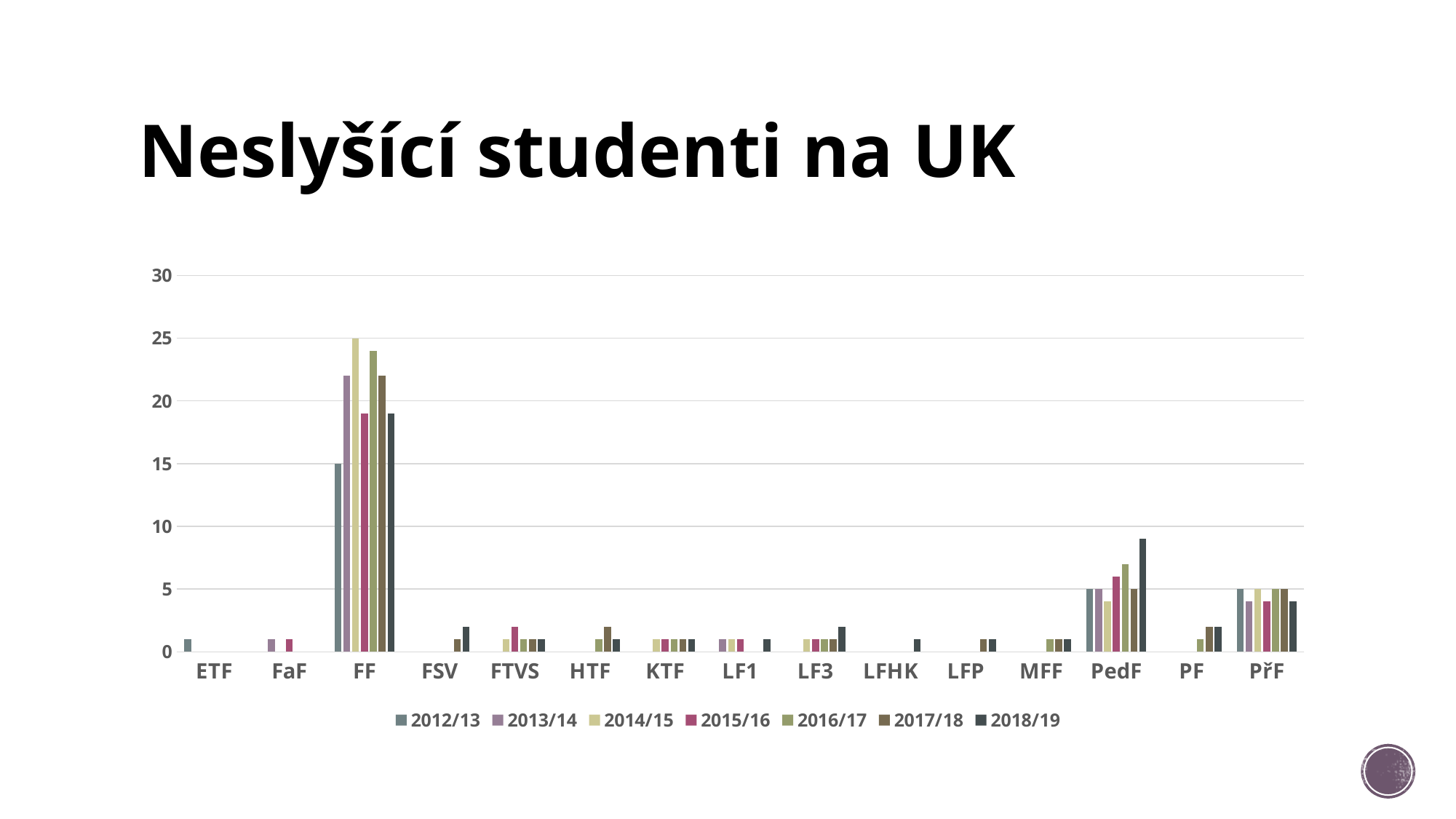
Which is larger: the value for FF in 2014/15 or the value for FF in 2015/16? FF in 2014/15 Which faculty has the highest number of deaf students across the years shown? FF Which is larger: the value for PedF in 2018/19 or the value for PřF in 2018/19? PedF in 2018/19 How many faculty categories are shown on the x axis? 15 What is the title of the chart slide? Neslyšící studenti na UK What kind of chart is shown on the slide? bar chart Is the value for PedF in 2018/19 greater or less than 10? less What is the value for FF in 2012/13? 15 Is the value for FF in 2018/19 greater or less than 15? greater How many series does the legend list? 7 What is the value for FF in 2014/15? 25 Is the value for FF in 2013/14 greater or less than 20? greater